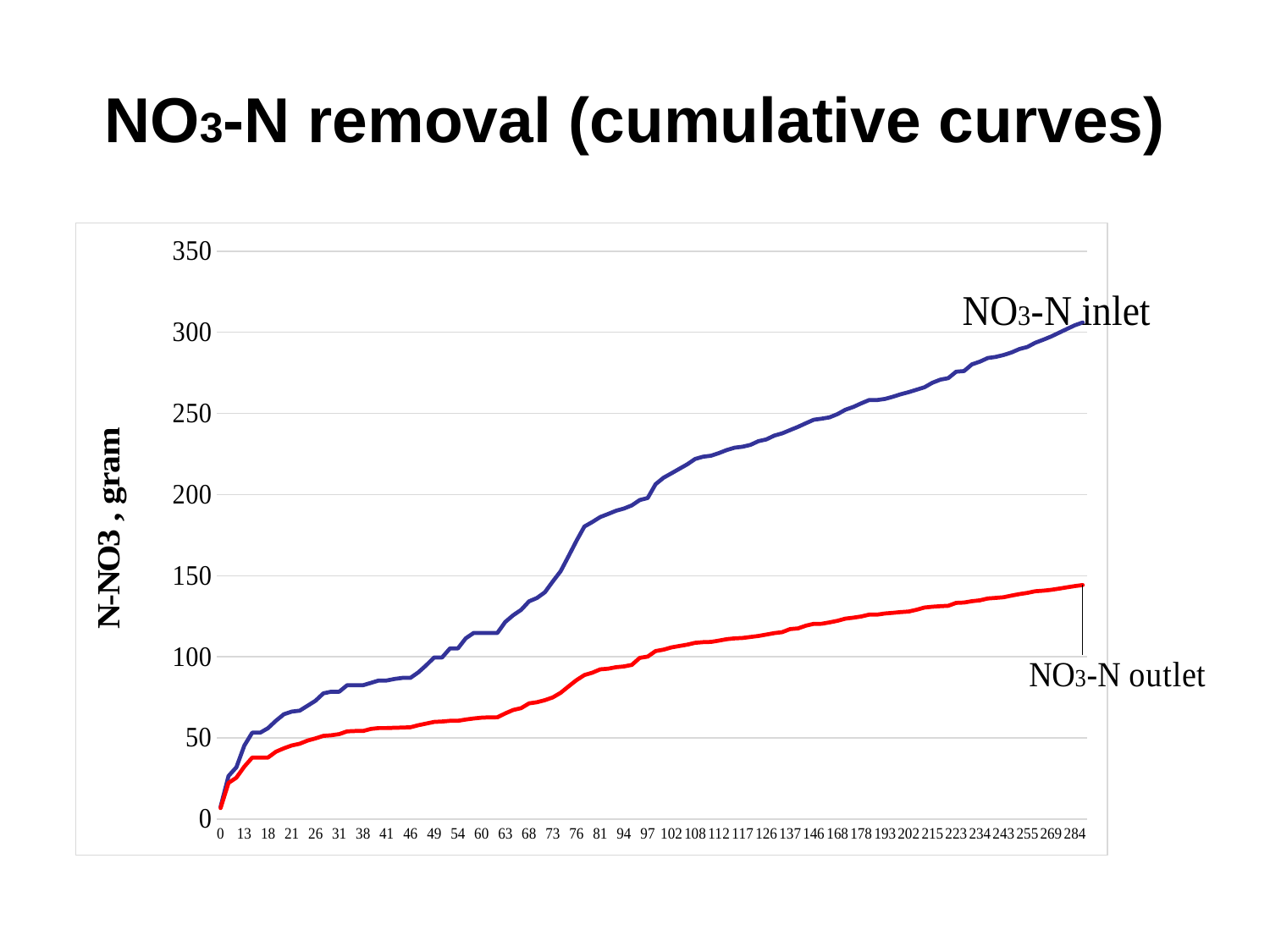
Is the value of NO3-N outlet at x = 76 greater or less than 100? less What is the label of the vertical axis? N-NO3 , gram Do the values of the NO3-N inlet series rise or fall along the x axis? rise Which series is drawn in blue? NO3-N inlet What kind of chart is shown on the slide? line chart How many data series are plotted on the chart? 2 Which series has the larger value at x = 284, NO3-N inlet or NO3-N outlet? NO3-N inlet Is the value of NO3-N inlet at x = 76 greater or less than 150? greater Is the value of NO3-N inlet at x = 284 greater or less than 250? greater Do the values of the NO3-N outlet series rise or fall along the x axis? rise What is the title of the chart on the slide? NO3-N removal (cumulative curves)